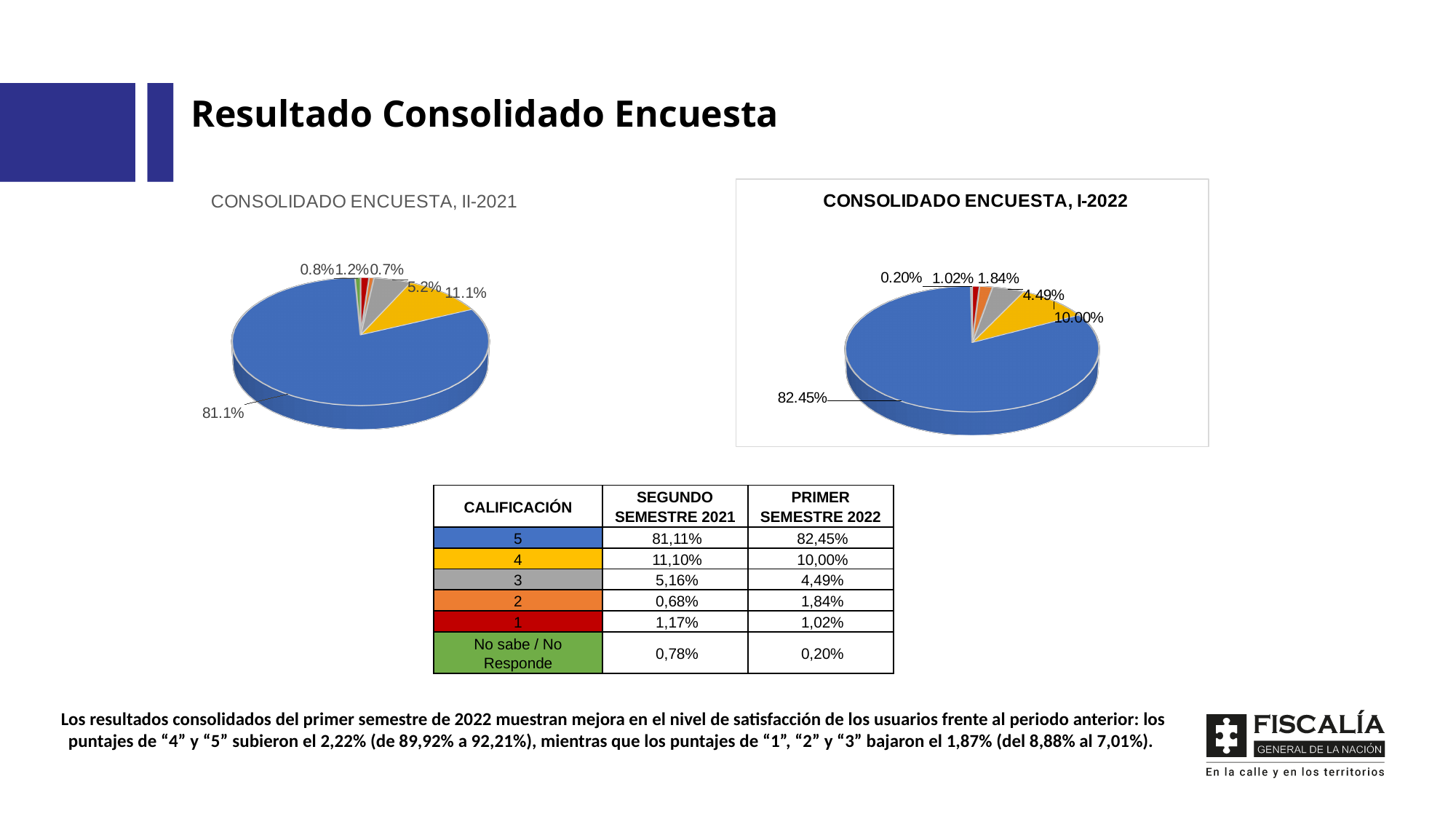
In the "CONSOLIDADO ENCUESTA, II-2021" chart, what is the value of the yellow slice? 11.1% In the "CONSOLIDADO ENCUESTA, I-2022" chart, what is the value of the largest slice? 82.45% What colour is the largest slice in the "CONSOLIDADO ENCUESTA, II-2021" chart? blue In the "CONSOLIDADO ENCUESTA, II-2021" chart, what is the value of the largest slice? 81.1% Which chart has the larger blue slice, "CONSOLIDADO ENCUESTA, II-2021" or "CONSOLIDADO ENCUESTA, I-2022"? CONSOLIDADO ENCUESTA, I-2022 What kind of chart is "CONSOLIDADO ENCUESTA, II-2021"? pie chart In the "CONSOLIDADO ENCUESTA, I-2022" chart, what is the value of the yellow slice? 10.00% In the "CONSOLIDADO ENCUESTA, I-2022" chart, what is the smallest slice value shown? 0.20% In the "CONSOLIDADO ENCUESTA, I-2022" chart, what is the value of the gray slice? 4.49% What is the difference between the largest slice in "CONSOLIDADO ENCUESTA, I-2022" (82.45%) and the yellow slice in the same chart (10.00%)? 72.45% How many slices does the "CONSOLIDADO ENCUESTA, I-2022" pie chart have? 6 In the "CONSOLIDADO ENCUESTA, II-2021" chart, what is the smallest slice value shown? 0.7%